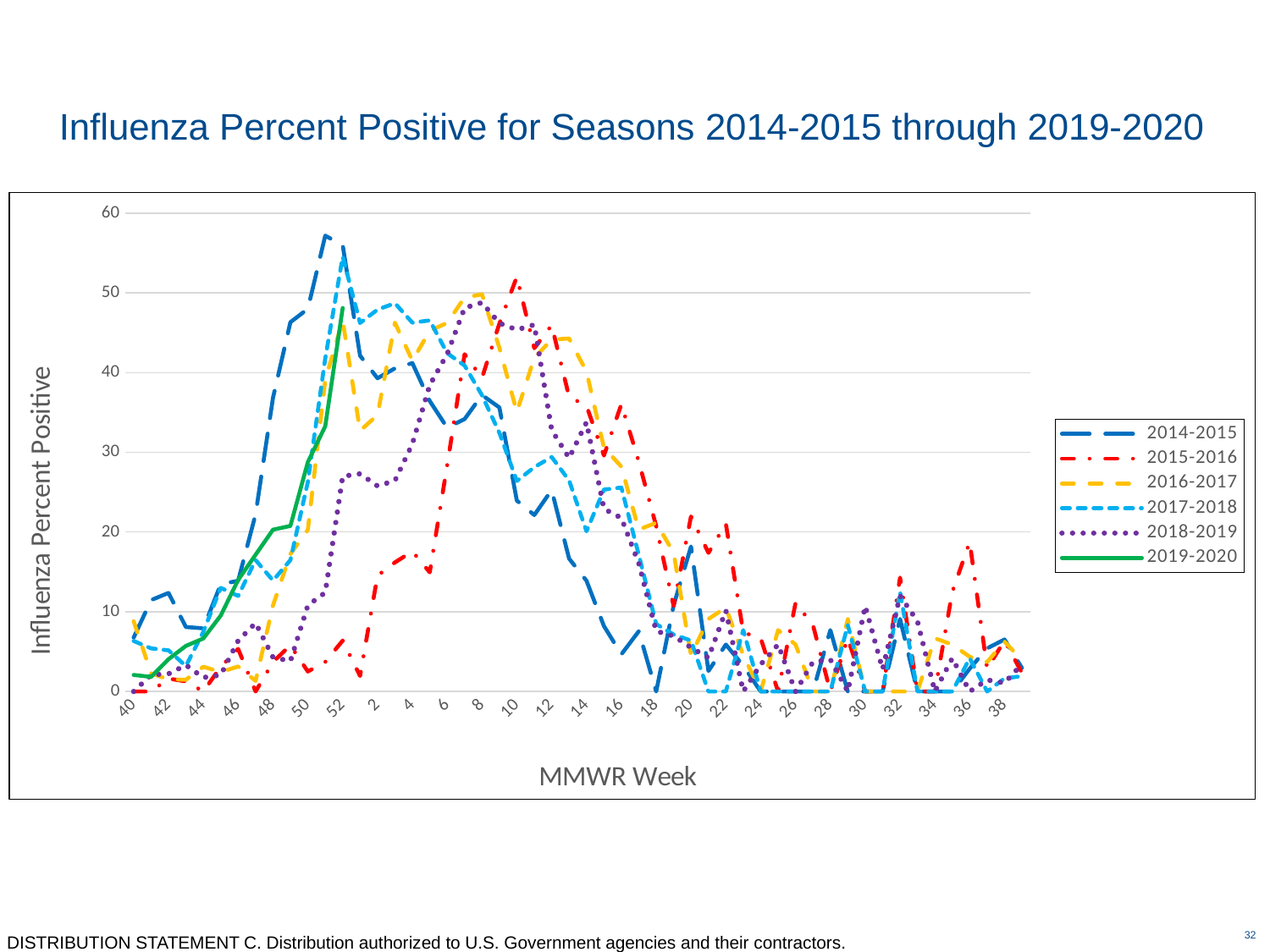
Does the 2019-2020 series rise or fall from week 40 to week 52? rise Is the value for the 2015-2016 series at week 40 greater or less than 10? less At week 48, which series has the larger value, 2014-2015 or 2015-2016? 2014-2015 What kind of chart is shown on the slide? line chart Is the value for the 2018-2019 series at week 8 greater or less than 40? greater What is the title of the chart? Influenza Percent Positive for Seasons 2014-2015 through 2019-2020 How many series does the legend list? 6 What is the label on the x axis of the chart? MMWR Week Is the value for the 2019-2020 series at week 52 greater or less than 40? greater At week 10, which series has the larger value, 2015-2016 or 2014-2015? 2015-2016